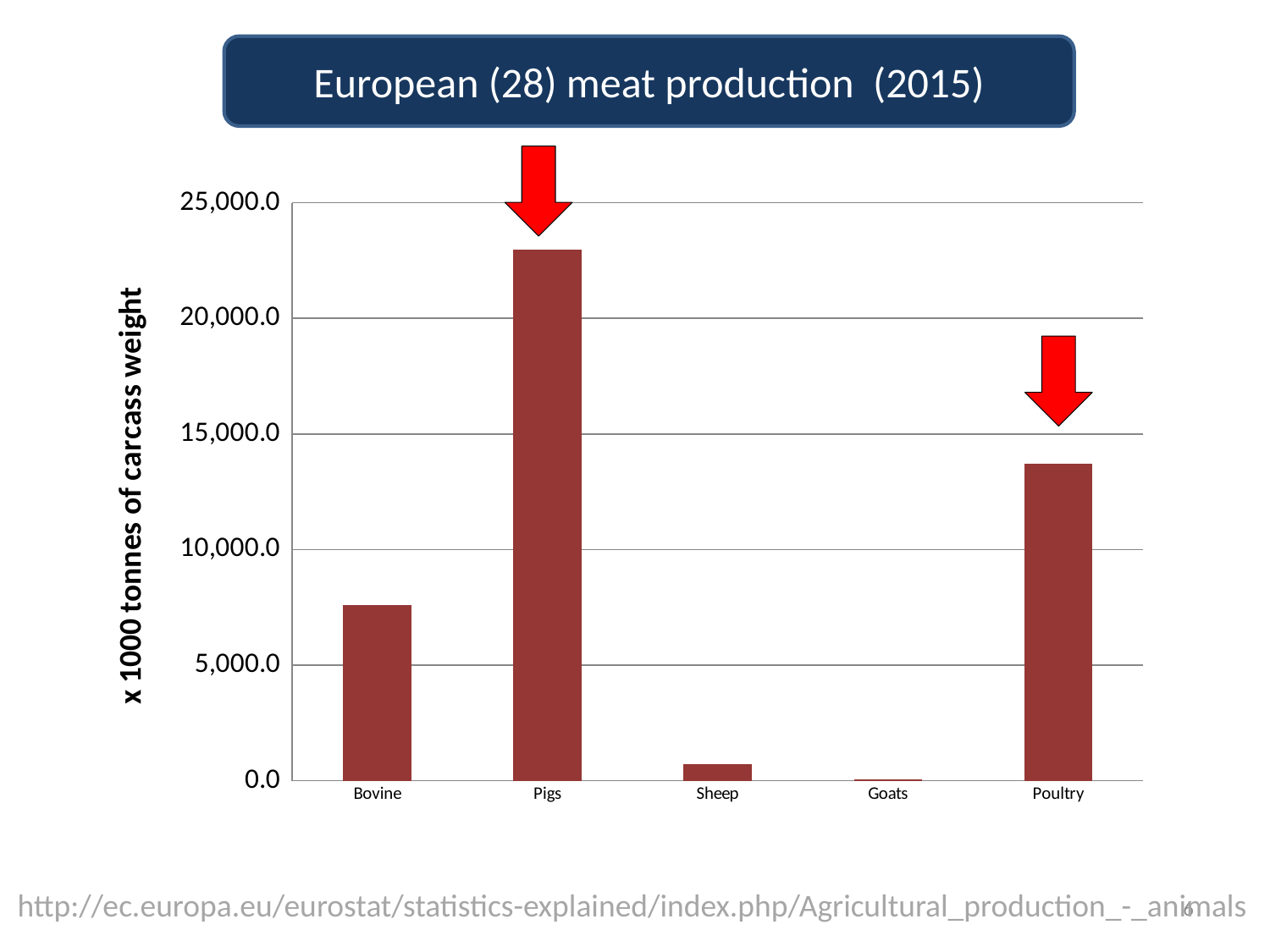
Which is larger, the value for Bovine or the value for Poultry? Poultry Which category has the highest meat production? Pigs Is the value for Bovine greater or less than 5,000.0? greater Is the value for Poultry greater or less than 15,000.0? less What is the label of the y axis? x 1000 tonnes of carcass weight Which is larger, the value for Sheep or the value for Goats? Sheep How many categories are shown on the x axis of the chart? 5 What is the title of the chart? European (28) meat production (2015) What kind of chart is shown on the slide? bar chart Is the value for Pigs greater or less than 20,000.0? greater Which category has the lowest meat production? Goats